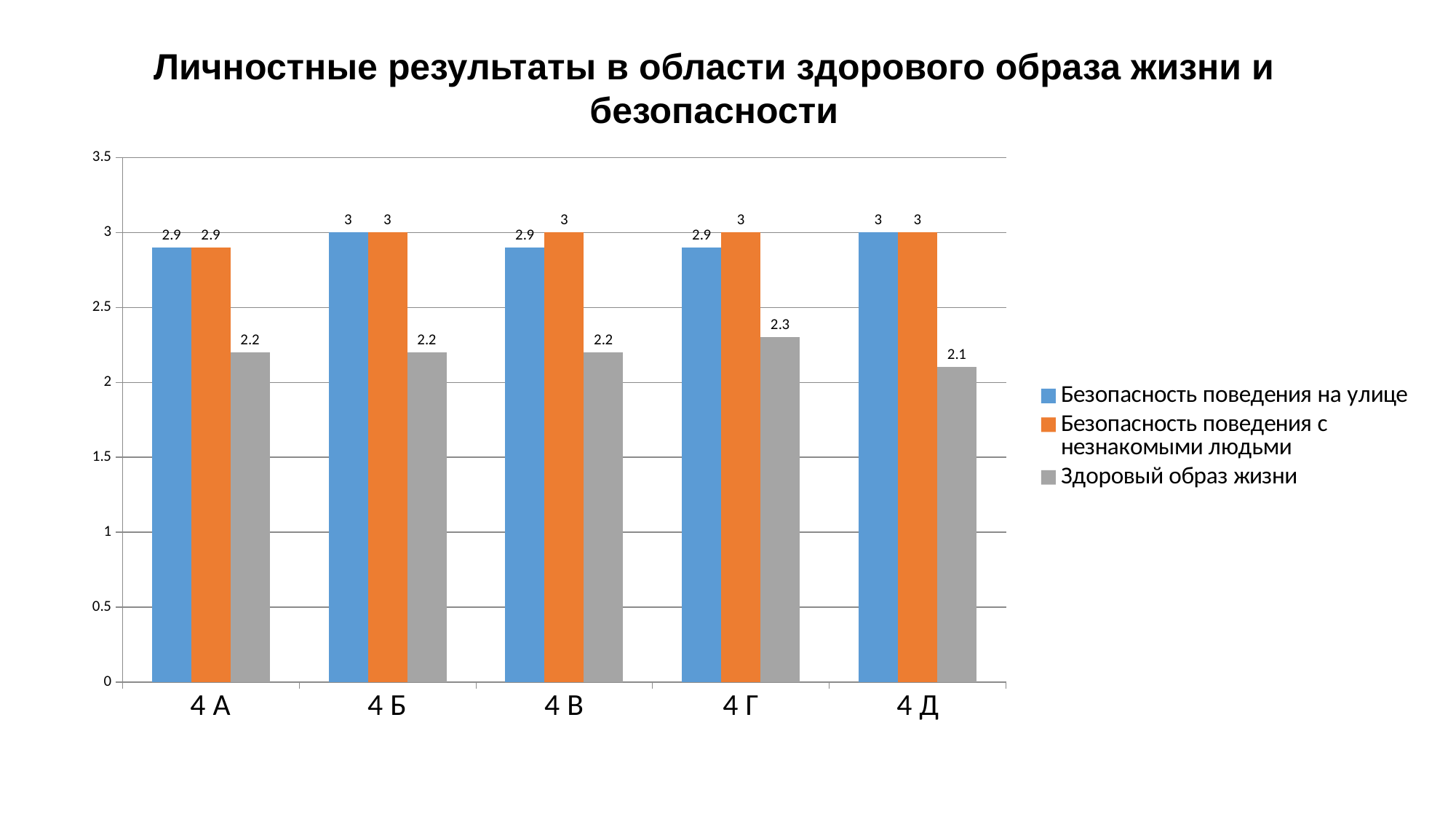
What kind of chart is shown on the slide? Bar chart How many series does the legend list? 3 What is the value for 'Здоровый образ жизни' in class 4 Д? 2.1 What is the value for 'Здоровый образ жизни' in class 4 Г? 2.3 What is the difference between 'Безопасность поведения с незнакомыми людьми' and 'Здоровый образ жизни' in class 4 Б? 0.8 What colour represents 'Здоровый образ жизни' in the chart? Grey How many classes are shown on the x axis? 5 Which is larger in class 4 Г: 'Безопасность поведения на улице' or 'Безопасность поведения с незнакомыми людьми'? Безопасность поведения с незнакомыми людьми What is the value for 'Безопасность поведения на улице' in class 4 А? 2.9 What is the value for 'Безопасность поведения с незнакомыми людьми' in class 4 В? 3 Which class has the lowest value for 'Здоровый образ жизни'? 4 Д Which class has the highest value for 'Здоровый образ жизни'? 4 Г